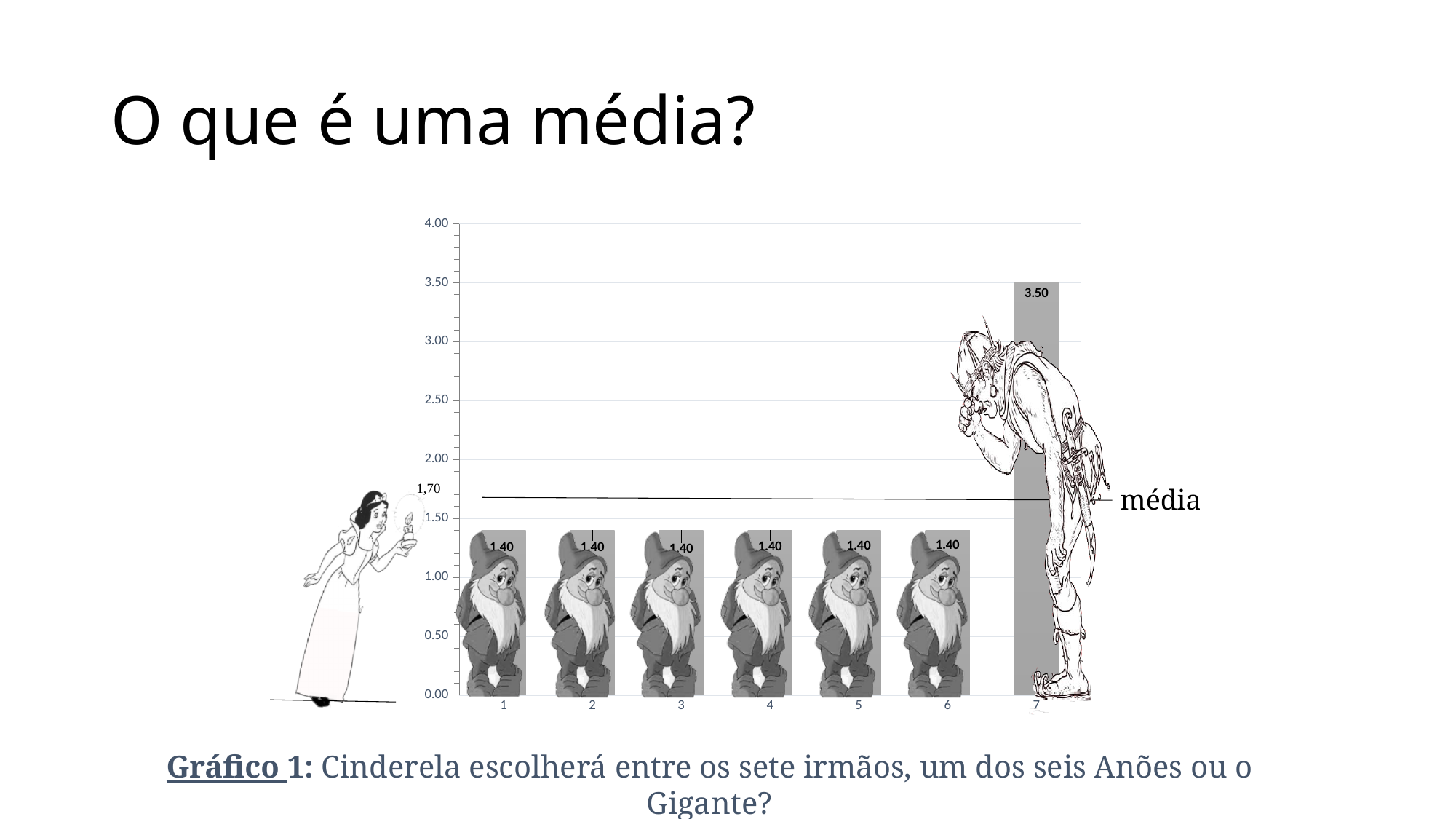
What is the value for category 4? 1.40 Which is larger, the value for category 7 or the value for category 2? Category 7 What is the difference between the value for category 7 and the value for category 6? 2.10 What is the value for category 1? 1.40 Is the value for category 7 greater or less than 3.00? greater What is the maximum value shown on the y axis? 4.00 What value is labelled on the horizontal line marked 'média'? 1,70 How many categories are shown on the x axis? 7 Which category has the highest value? 7 Is the value for category 3 greater or less than 1.50? less What kind of chart is shown? Bar chart What is the value for category 7? 3.50